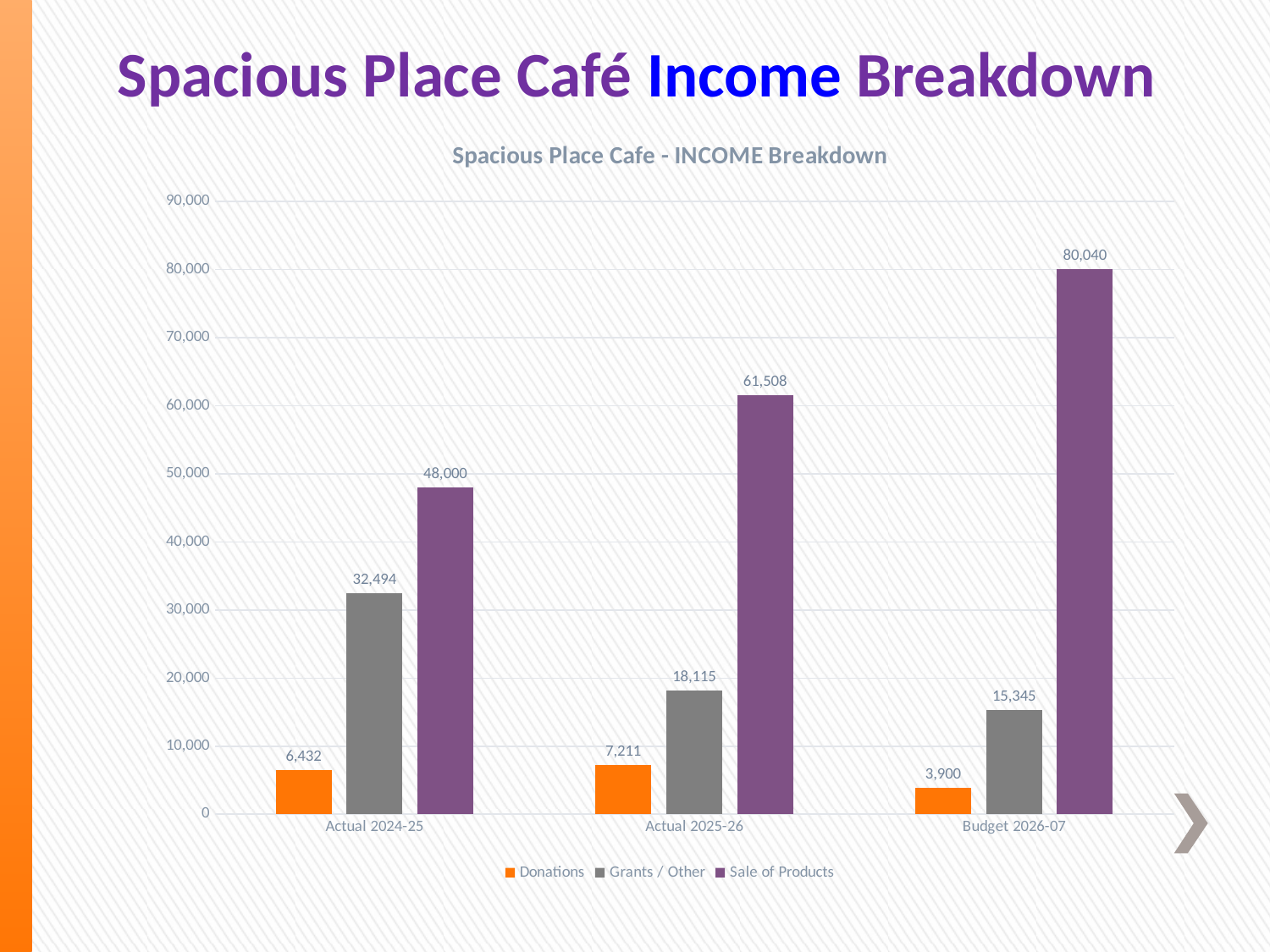
How many series does the legend list? 3 How many categories are shown on the x axis? 3 What kind of chart is shown? bar chart What is the difference between Sale of Products in Budget 2026-07 and Actual 2025-26? 18,532 Which category has the highest Sale of Products value? Budget 2026-07 Which category has the lowest Donations value? Budget 2026-07 What is the title of the chart? Spacious Place Cafe - INCOME Breakdown What is the value for Grants / Other in Actual 2024-25? 32,494 Which is larger: Grants / Other in Actual 2025-26 or Grants / Other in Budget 2026-07? Actual 2025-26 Is the value for Sale of Products in Actual 2024-25 greater or less than 40,000? greater What is the value for Donations in Budget 2026-07? 3,900 What is the value for Sale of Products in Actual 2025-26? 61,508